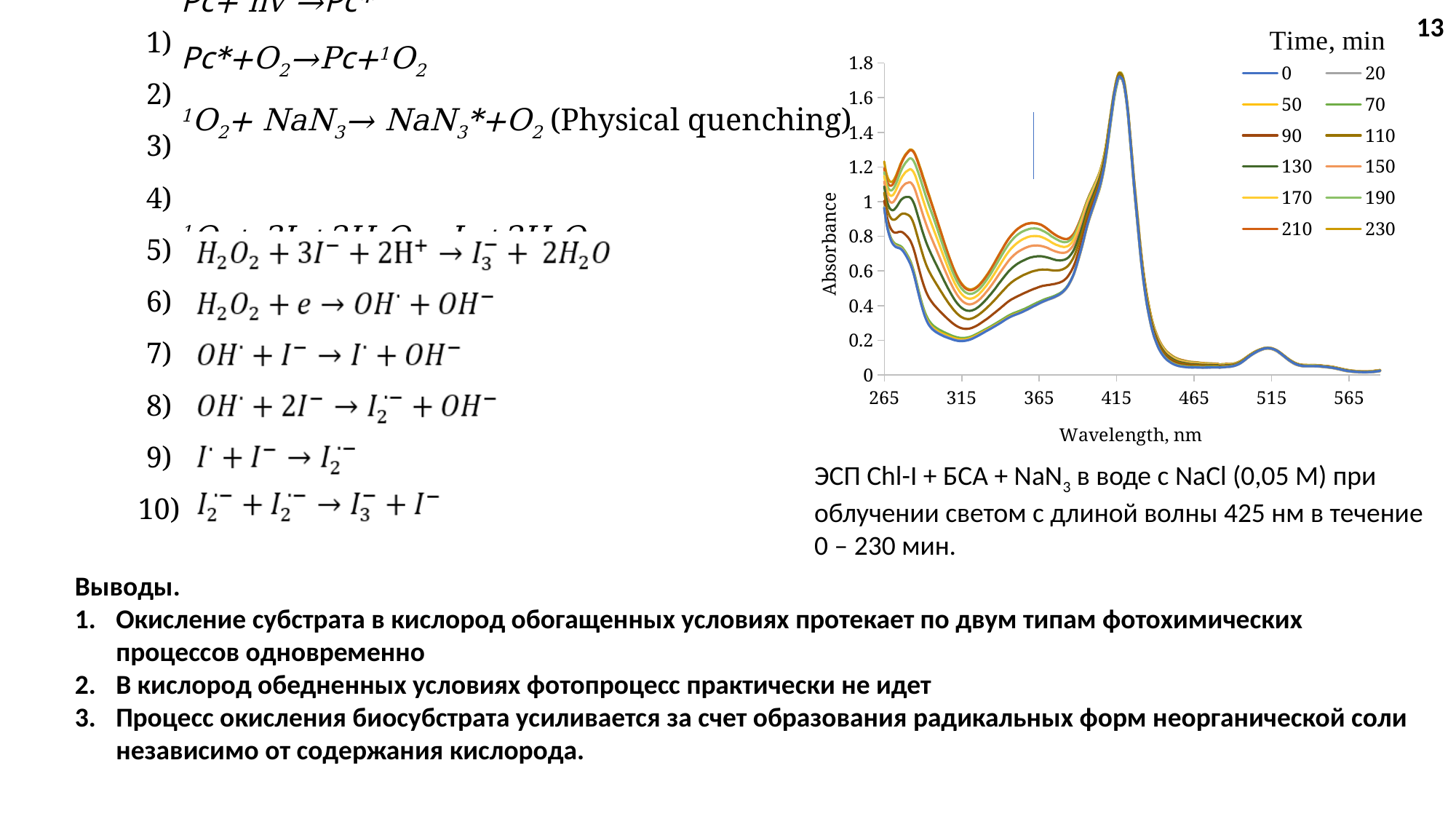
Is the absorbance at 565 nm greater or less than 0.2? less Does the absorbance rise or fall along the x axis between 415 nm and 465 nm? fall What is the title of the chart legend? Time, min Is the absorbance of the small peak near 515 nm greater or less than 0.4? less What is the highest value shown on the y axis of the chart? 1.8 What kind of chart is shown on the slide? line chart How many series does the chart legend list? 12 Which is larger: the absorbance at 415 nm or the absorbance at 515 nm? 415 nm Is the peak absorbance near 415 nm greater or less than 1.6? greater Does the absorbance rise or fall along the x axis between 315 nm and 365 nm? rise What is the label of the x axis of the chart? Wavelength, nm